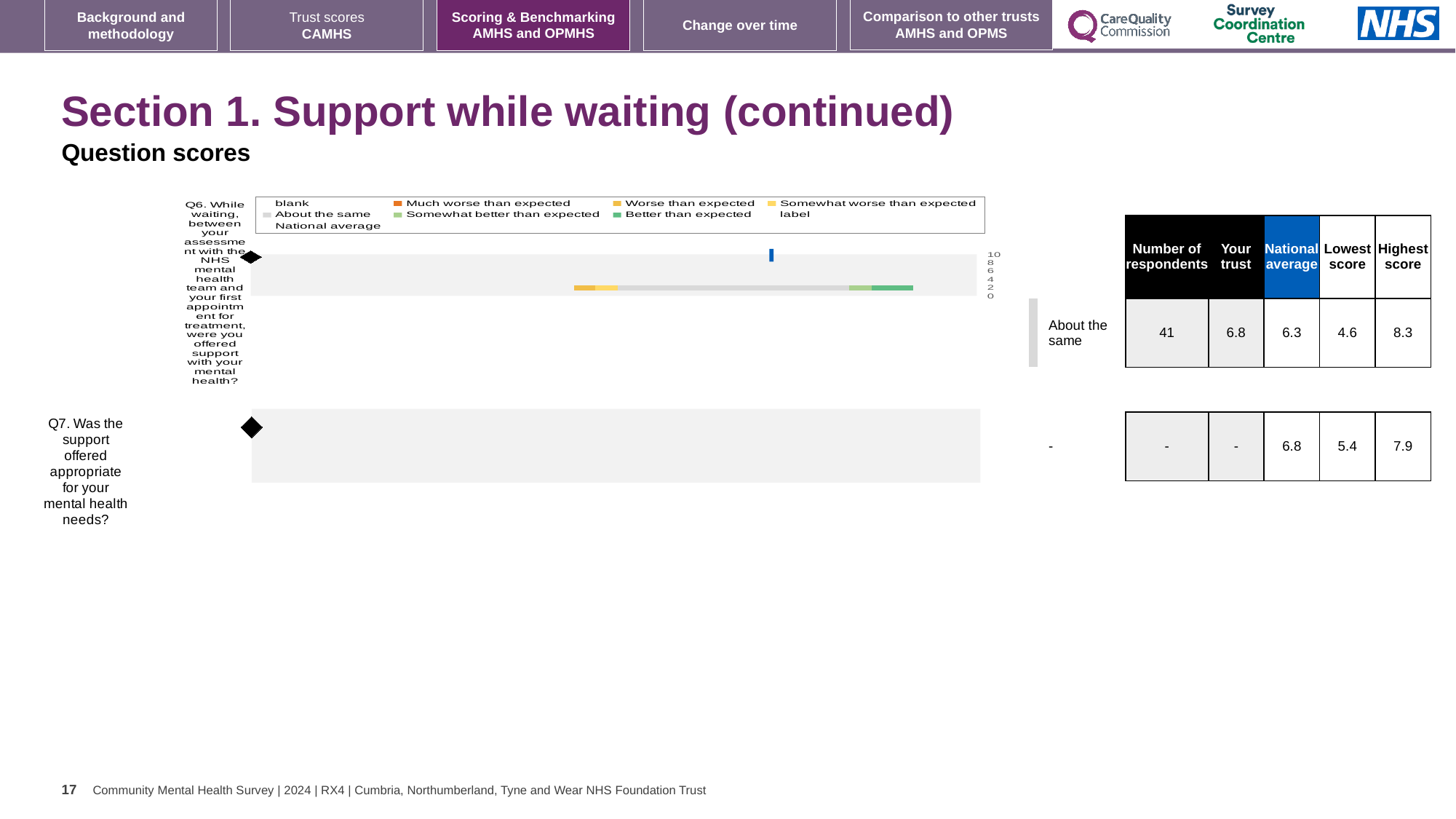
What kind of chart is used to show the Q6 benchmarking result? bar chart According to the table, what is the national average score for Q7? 6.8 What colour does the legend use for 'Much worse than expected'? orange What is the highest value shown on the chart's axis? 10 Is the national average marker for Q6 greater or less than 4 on the chart axis? greater Which benchmark category is Q6 placed in, as labelled next to the chart? About the same According to the table, what is the difference between the highest score and the lowest score for Q6? 3.7 According to the table, how many respondents answered Q6? 41 Is the national average marker for Q6 greater or less than 8 on the chart axis? less According to the table, which is larger for Q6: the 'Your trust' score or the national average? Your trust According to the table, what is the national average score for Q6? 6.3 According to the table, what is the 'Your trust' score for Q6? 6.8